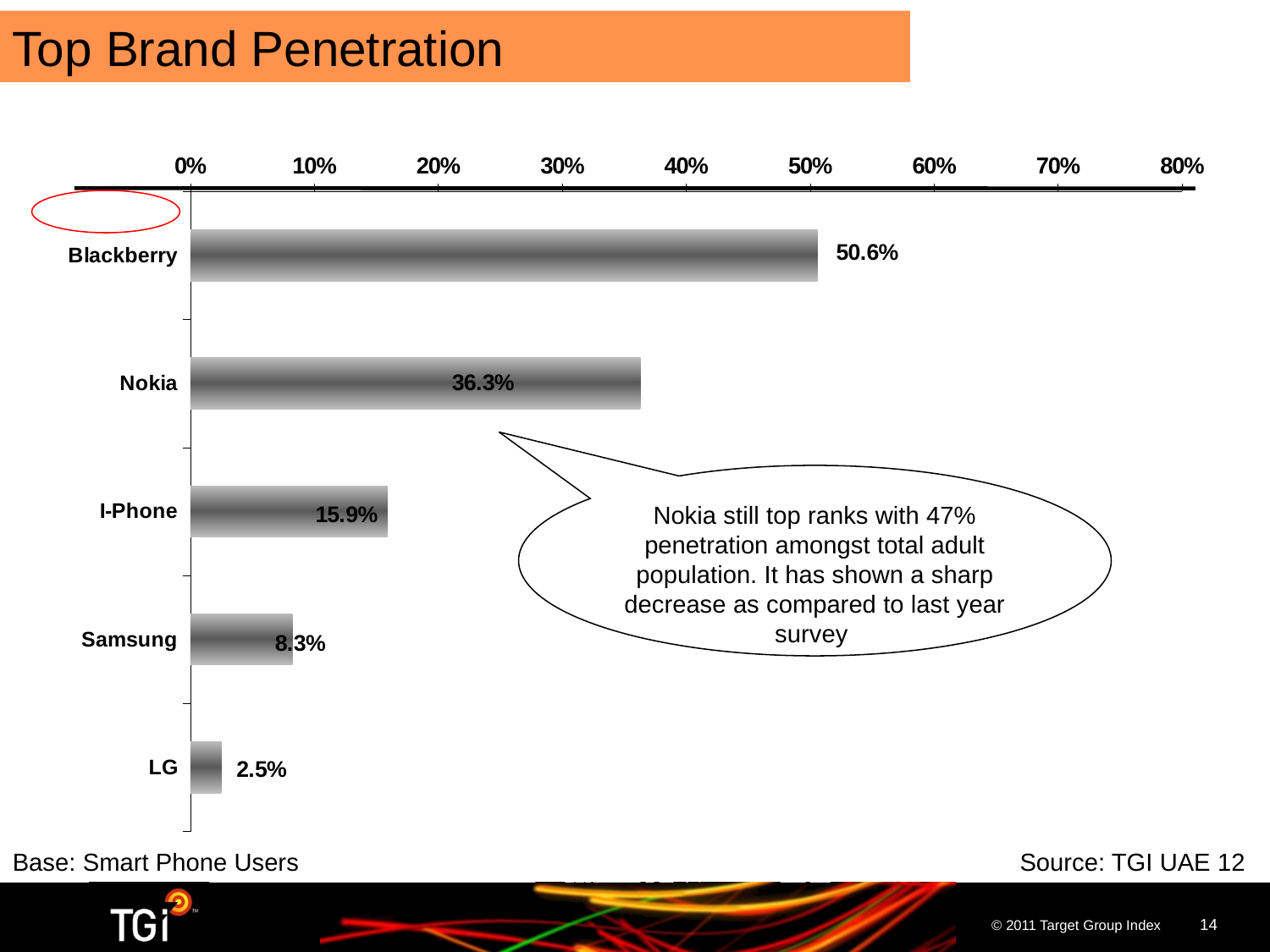
Is the value for Nokia greater or less than 40%? less Which brand has the highest penetration? Blackberry What is the penetration value for Blackberry? 50.6% What is the difference in penetration between Blackberry and Nokia? 14.3% What is the penetration value for LG? 2.5% What kind of chart is shown on the slide? Bar chart Which brand has the lowest penetration? LG What is the penetration value for Samsung? 8.3% Which has higher penetration, I-Phone or Samsung? I-Phone How many brands are shown in the chart? 5 What is the penetration value for Nokia? 36.3% What is the penetration value for I-Phone? 15.9%